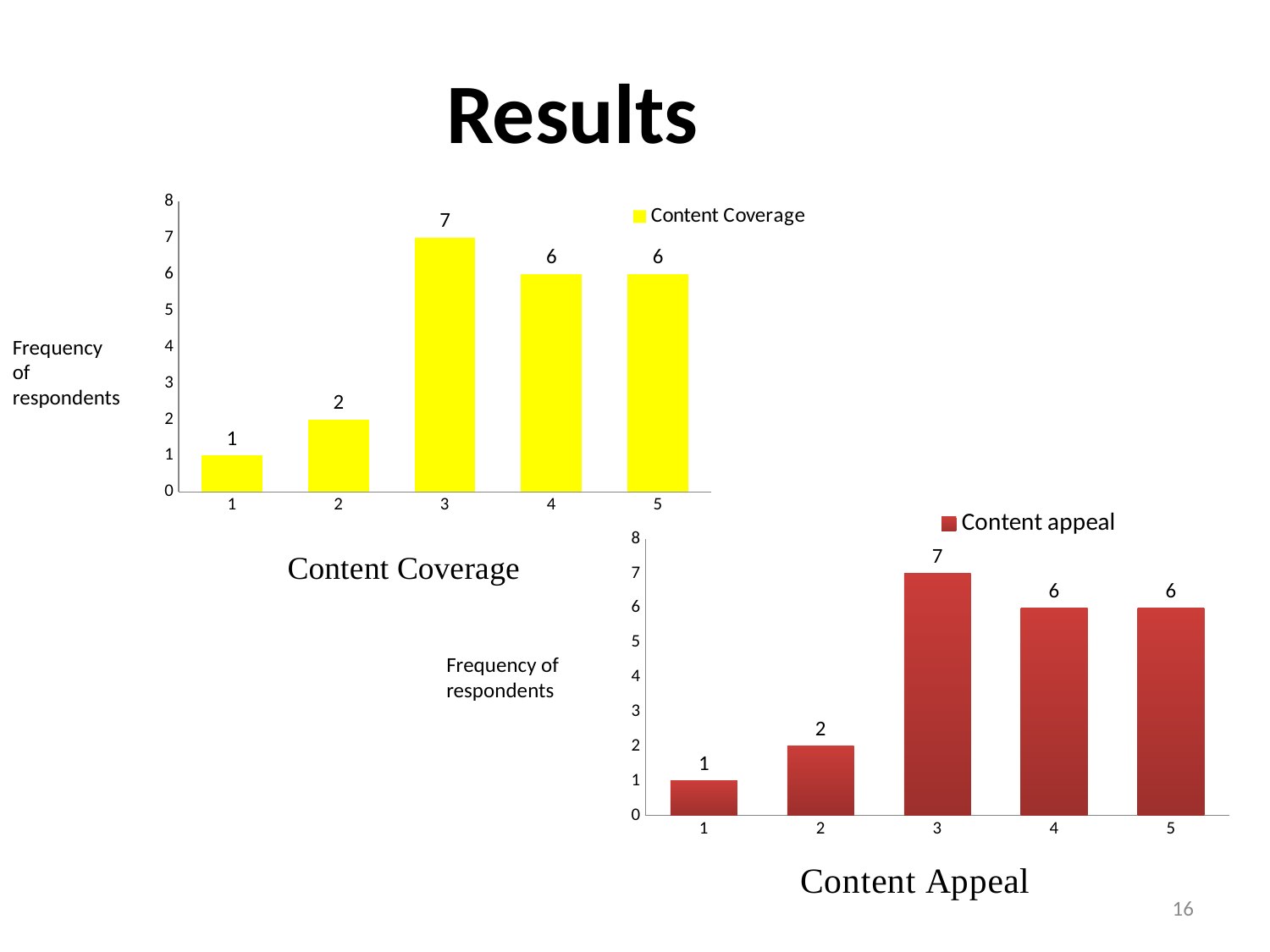
How many categories are shown in the Content Coverage chart? 5 In the Content Appeal chart, which is larger, the value for category 4 or the value for category 1? Category 4 How many series does the legend of the Content Appeal chart list? 1 What colour are the bars in the Content Coverage chart? Yellow What kind of chart is the Content Coverage chart? Bar chart In the Content Appeal chart, which category has the lowest value? 1 In the Content Coverage chart, which category has the highest value? 3 In the Content Appeal chart, is the value for category 3 greater or less than 5? greater In the Content Appeal chart, what is the total of the values for categories 4 and 5? 12 In the Content Appeal chart, what is the value for category 2? 2 In the Content Coverage chart, what is the value for category 3? 7 In the Content Coverage chart, what is the difference between the values for category 3 and category 2? 5